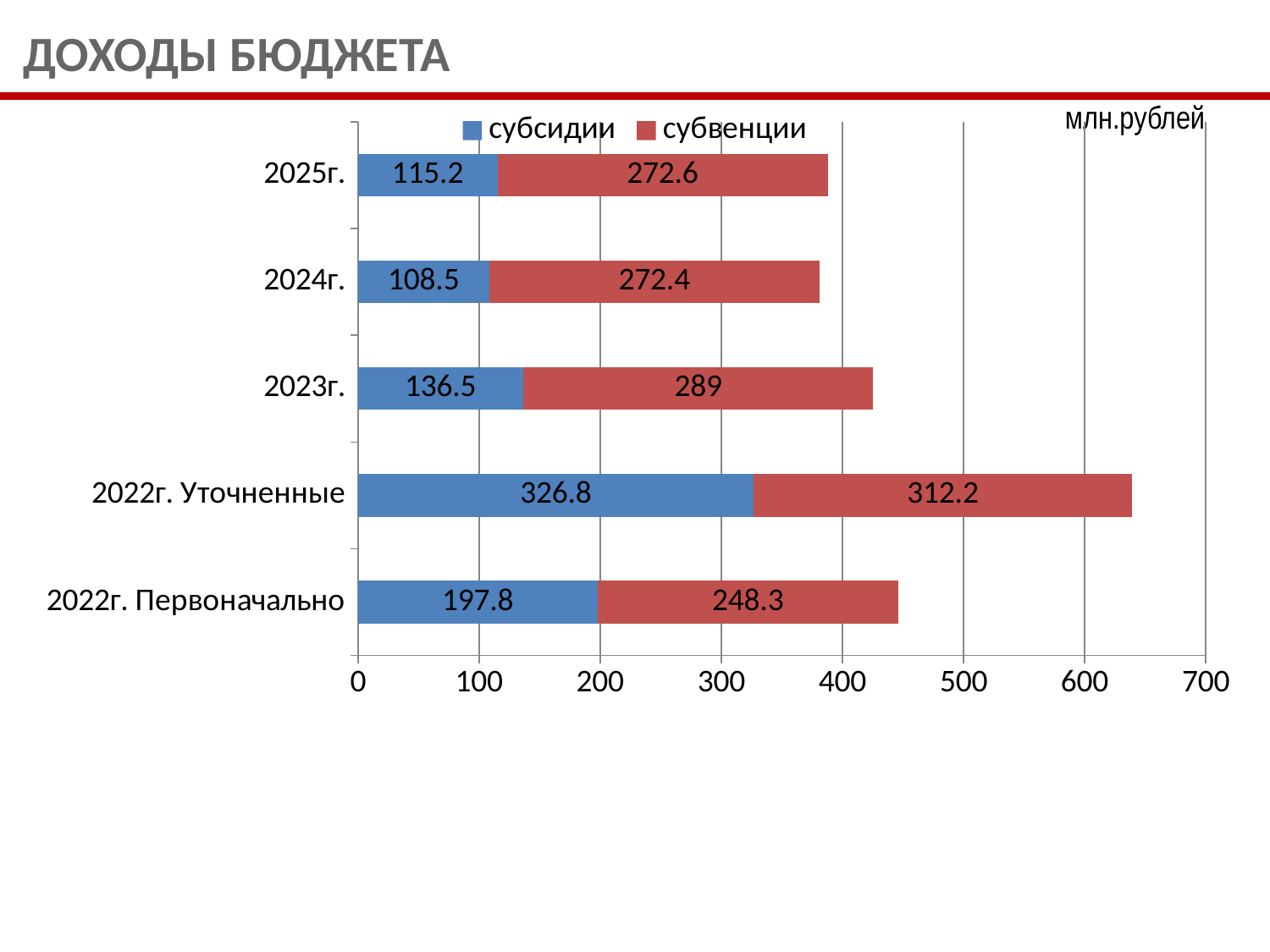
What is the total of the stacked bar for 2022г. Уточненные? 639 Which category has the highest value for субсидии? 2022г. Уточненные What kind of chart is shown on the slide? Stacked bar chart What is the total of the stacked bar for 2022г. Первоначально? 446.1 What is the value of субвенции for 2023г.? 289 What is the value of субсидии for 2022г. Уточненные? 326.8 What is the difference between субвенции for 2023г. and субвенции for 2024г.? 16.6 How many series does the legend list? 2 Which category has the lowest value for субвенции? 2022г. Первоначально Which is larger: субсидии for 2023г. or субсидии for 2024г.? субсидии for 2023г. What is the value of субсидии for 2025г.? 115.2 How many categories are shown on the chart? 5